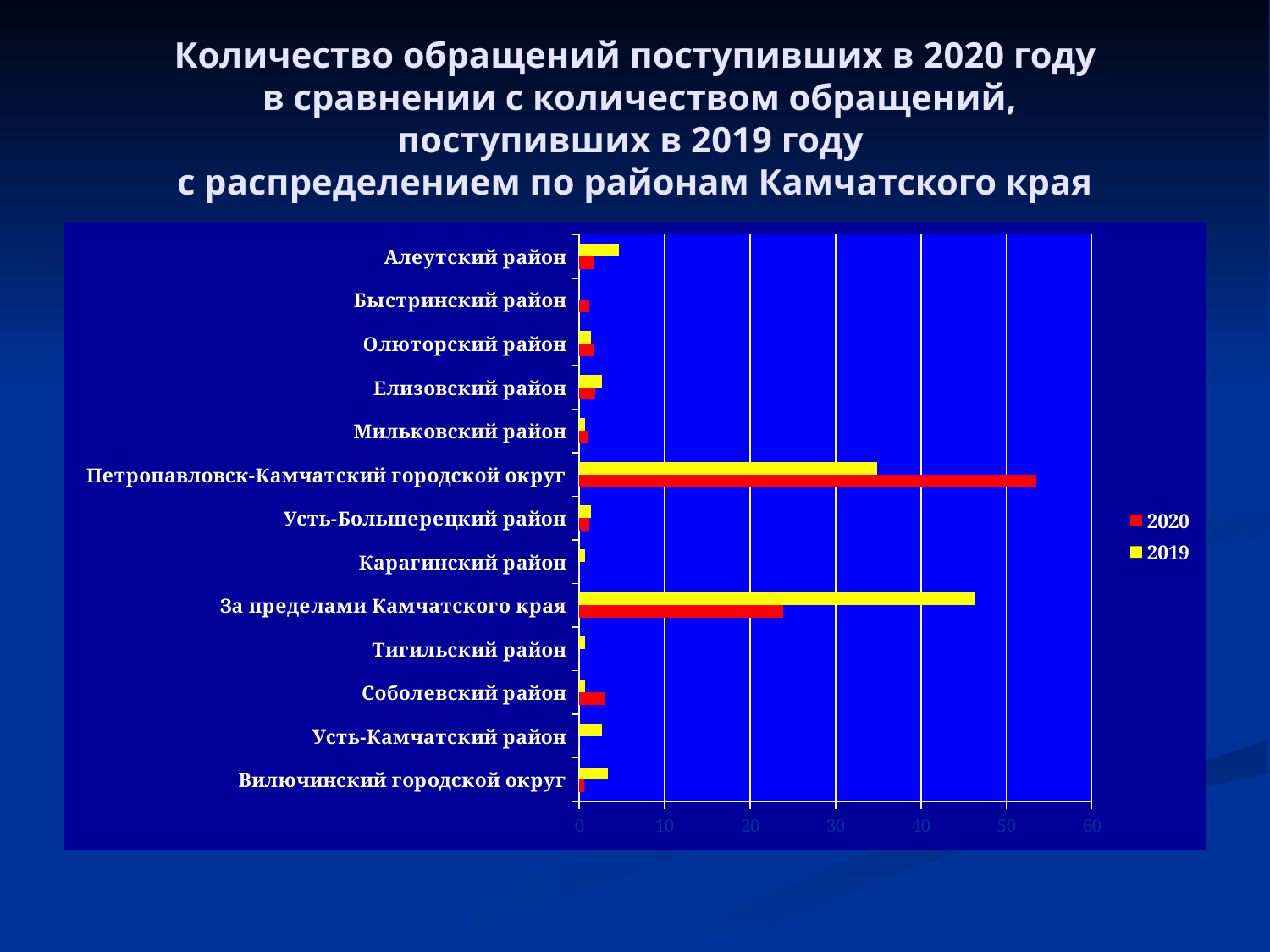
Which colour represents the 2019 series in the legend? yellow Which category has the highest value for 2019? За пределами Камчатского края Which category has the highest value for 2020? Петропавловск-Камчатский городской округ How many districts (categories) are plotted on the chart? 13 For За пределами Камчатского края, which year has the larger value, 2020 or 2019? 2019 Is the 2020 value for За пределами Камчатского края greater or less than 30? less How many series does the legend list? 2 Is the 2019 value for За пределами Камчатского края greater or less than 40? greater Is the 2019 value for Петропавловск-Камчатский городской округ greater or less than 40? less What kind of chart is shown on the slide? bar chart For Петропавловск-Камчатский городской округ, which year has the larger value, 2020 or 2019? 2020